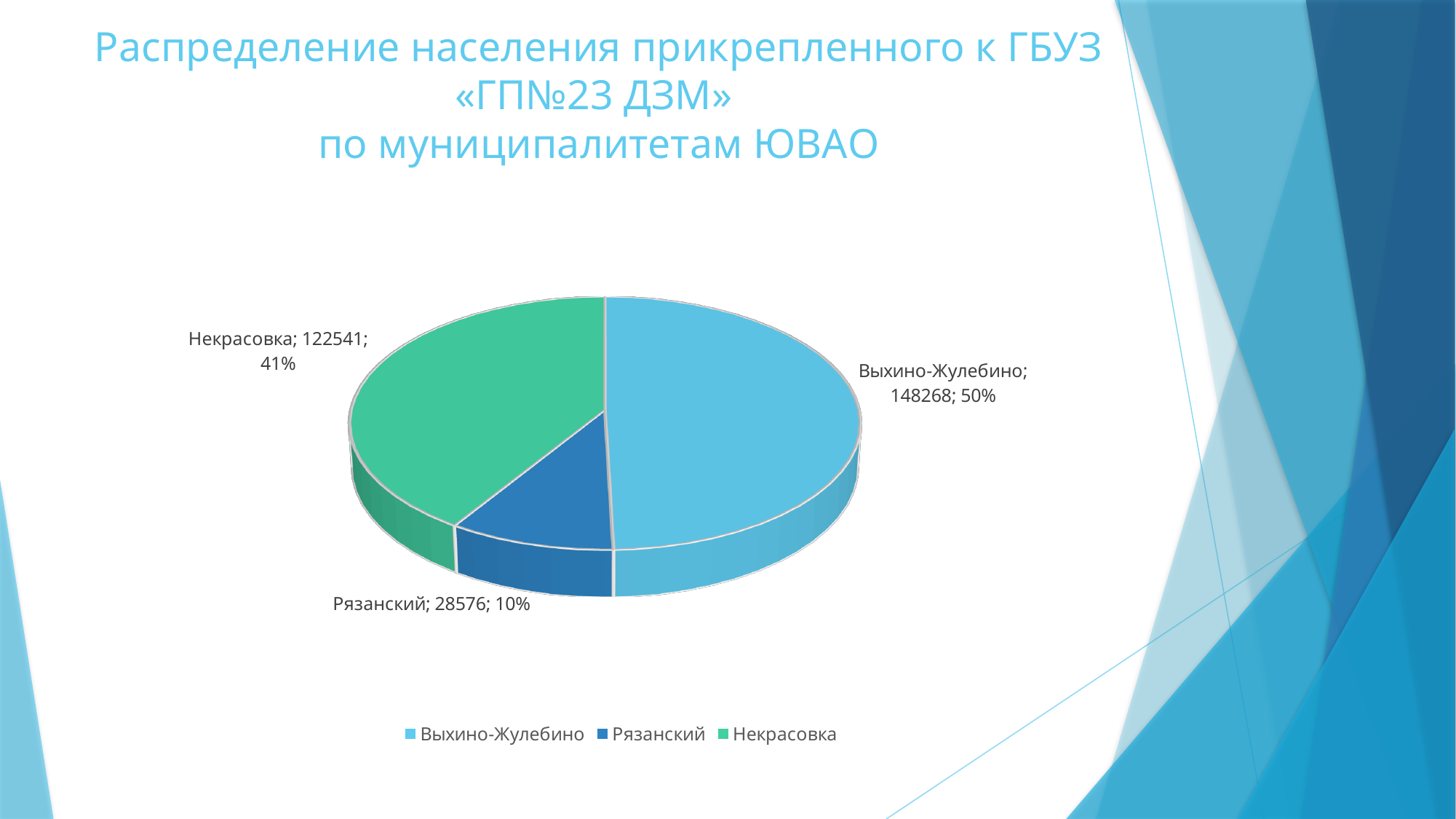
Which municipality has the smallest slice? Рязанский What is the difference between the values for Выхино-Жулебино and Некрасовка? 25727 Which municipality has the largest slice? Выхино-Жулебино What is the population value for Выхино-Жулебино? 148268 What share of the pie does Рязанский represent? 10% Which colour represents Некрасовка in the legend? Green What kind of chart is shown on the slide? Pie chart What is the population value for Некрасовка? 122541 How many slices does the pie chart have? 3 Which is larger, the value for Некрасовка or the value for Рязанский? Некрасовка What share of the pie does Некрасовка represent? 41% What is the population value for Рязанский? 28576